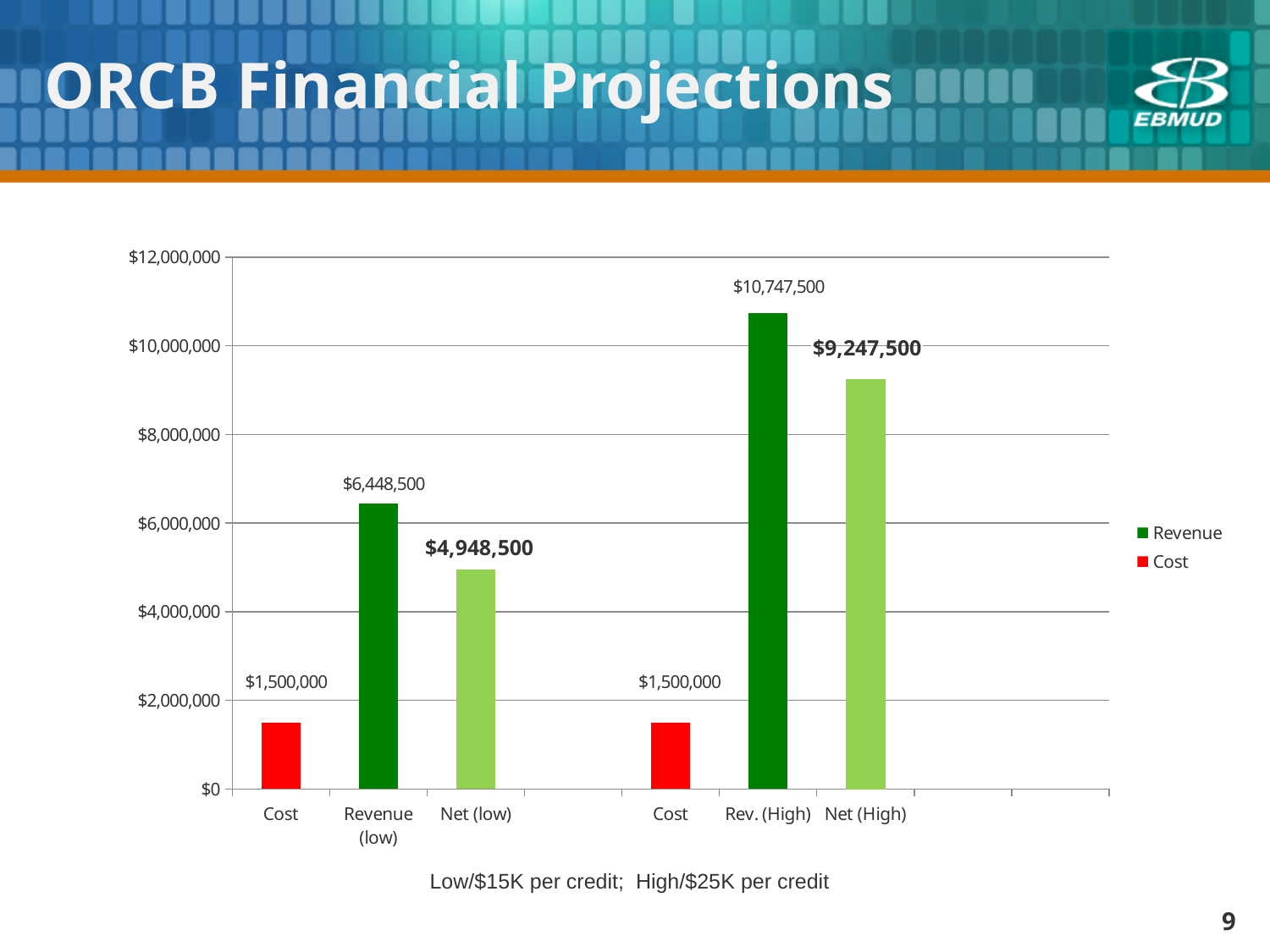
What kind of chart is shown on the slide? Bar chart Which bar has the highest value? Rev. (High) Which is larger, Net (High) or Revenue (low)? Net (High) Is the value for Net (low) greater or less than $4,000,000? greater How many series does the legend list? 2 What is the difference between Rev. (High) and Revenue (low)? $4,299,000 How many bars are plotted on the chart? 6 What is the difference between Revenue (low) and the Cost bar next to it? $4,948,500 What is the value of the Rev. (High) bar? $10,747,500 What is the value of the Net (low) bar? $4,948,500 What is the value of the Net (High) bar? $9,247,500 What is the value of the Revenue (low) bar? $6,448,500